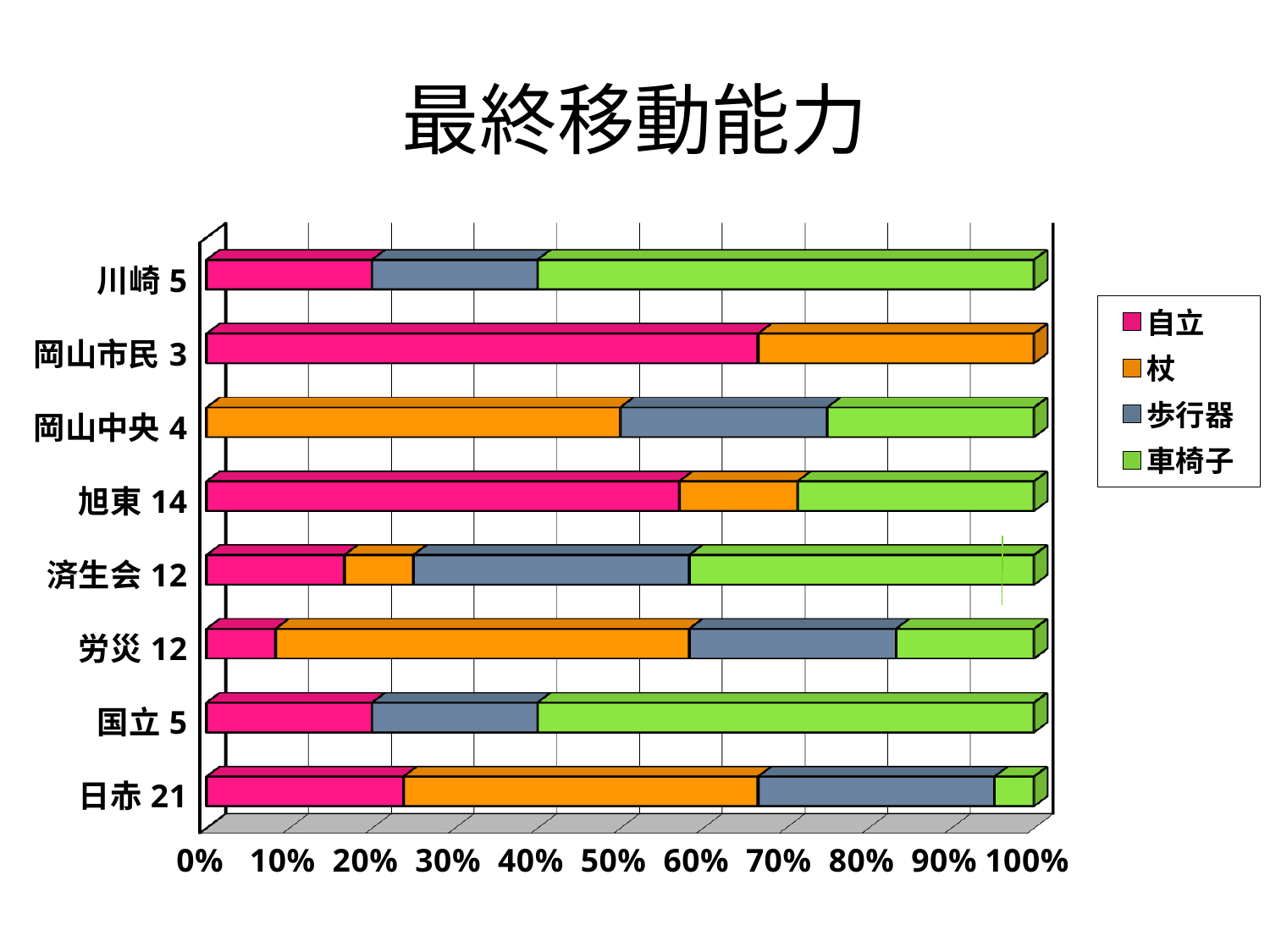
How many series does the legend list? 4 Is the 自立 share for 岡山市民 3 greater or less than 60%? greater How many categories (hospitals) are plotted on the chart? 8 Which has the larger 自立 share, 岡山市民 3 or 旭東 14? 岡山市民 3 What is the title of the chart? 最終移動能力 What kind of chart is shown on the slide? bar chart Is the 杖 share for 岡山中央 4 greater or less than 40%? greater Is the 車椅子 share for 川崎 5 greater or less than 50%? greater Which series is shown in green in the legend? 車椅子 Which category has the largest 自立 share? 岡山市民 3